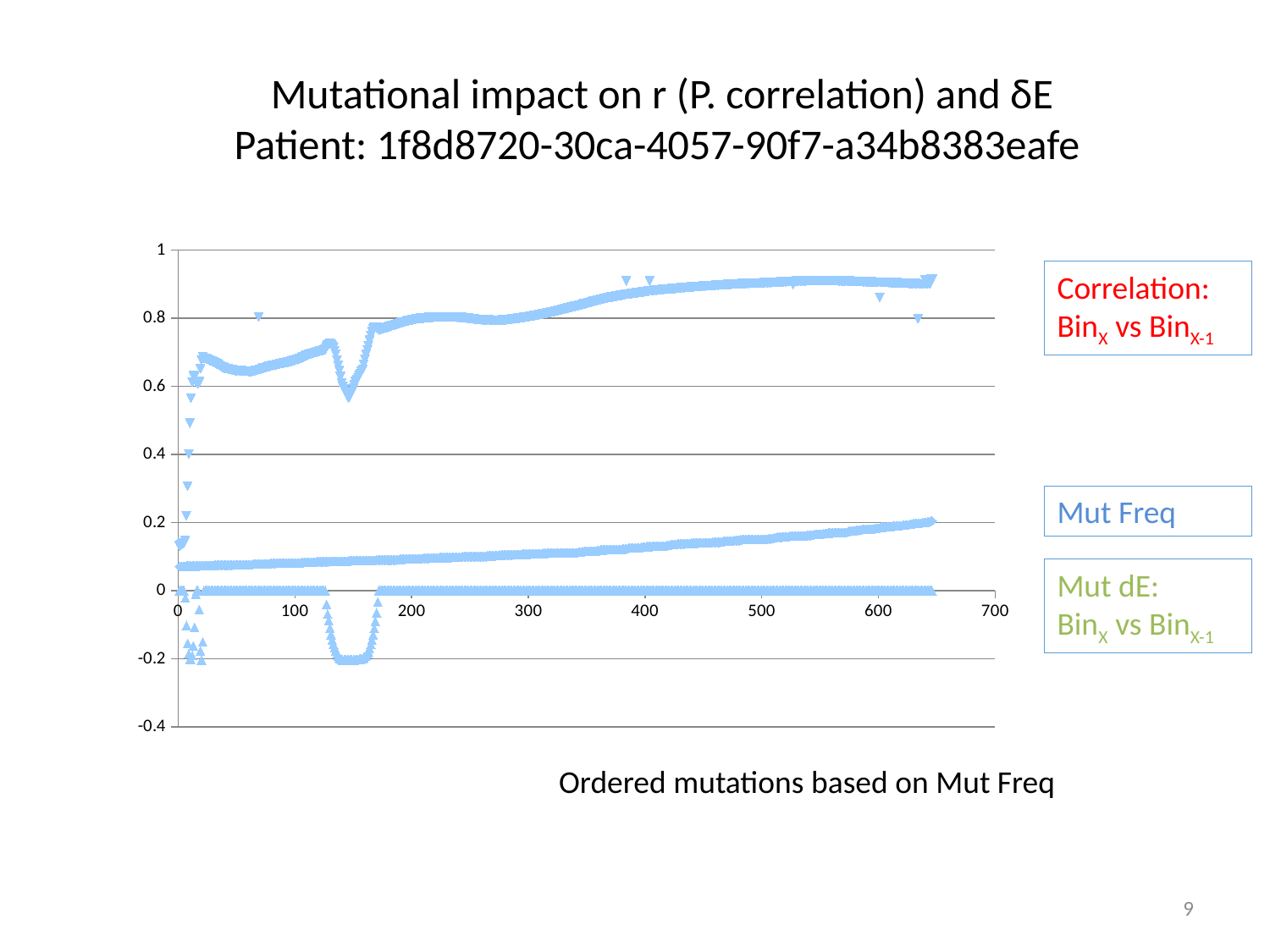
Is the Mut dE value at x = 150 greater or less than 0? less Is the Mut Freq value at x = 500 greater or less than 0.2? less What is the highest value shown on the y axis of the chart? 1 How many data series are labelled beside the chart? 3 Does the Correlation series generally rise or fall from x = 100 to x = 600? rise Is the Correlation value at x = 400 greater or less than 0.8? greater At x = 400, which series has the larger value: Correlation or Mut Freq? Correlation Which series has the lowest values on the chart, dipping below 0? Mut dE What kind of chart is shown on the slide? scatter chart What is the label of the x axis of the chart? Ordered mutations based on Mut Freq Does the Mut Freq series rise or fall as you move from left to right along the x axis? rise